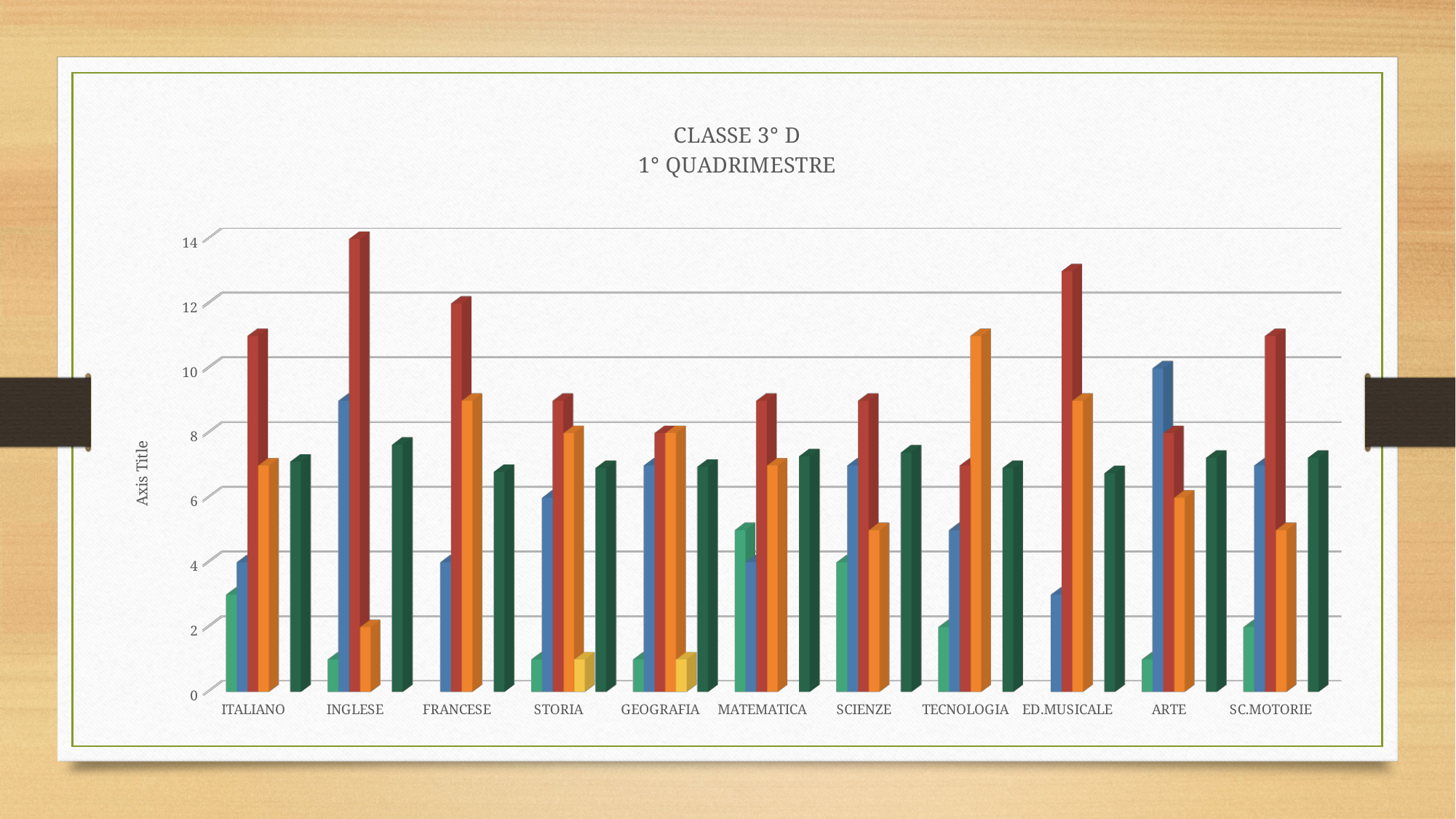
How many subject categories are shown along the x axis? 11 Is the value of the red bar for INGLESE greater or less than 12? greater Is the value of the blue bar for ARTE greater or less than 8? greater What is the title of the chart? CLASSE 3° D 1° QUADRIMESTRE Is the value of the orange bar for INGLESE greater or less than 4? less For ITALIANO, which is larger: the red bar or the blue bar? the red bar Which category has the tallest red bar? INGLESE Which category has the tallest orange bar? TECNOLOGIA What label is shown on the vertical axis? Axis Title What kind of chart is shown on the slide? bar chart For ED.MUSICALE, which is larger: the red bar or the orange bar? the red bar